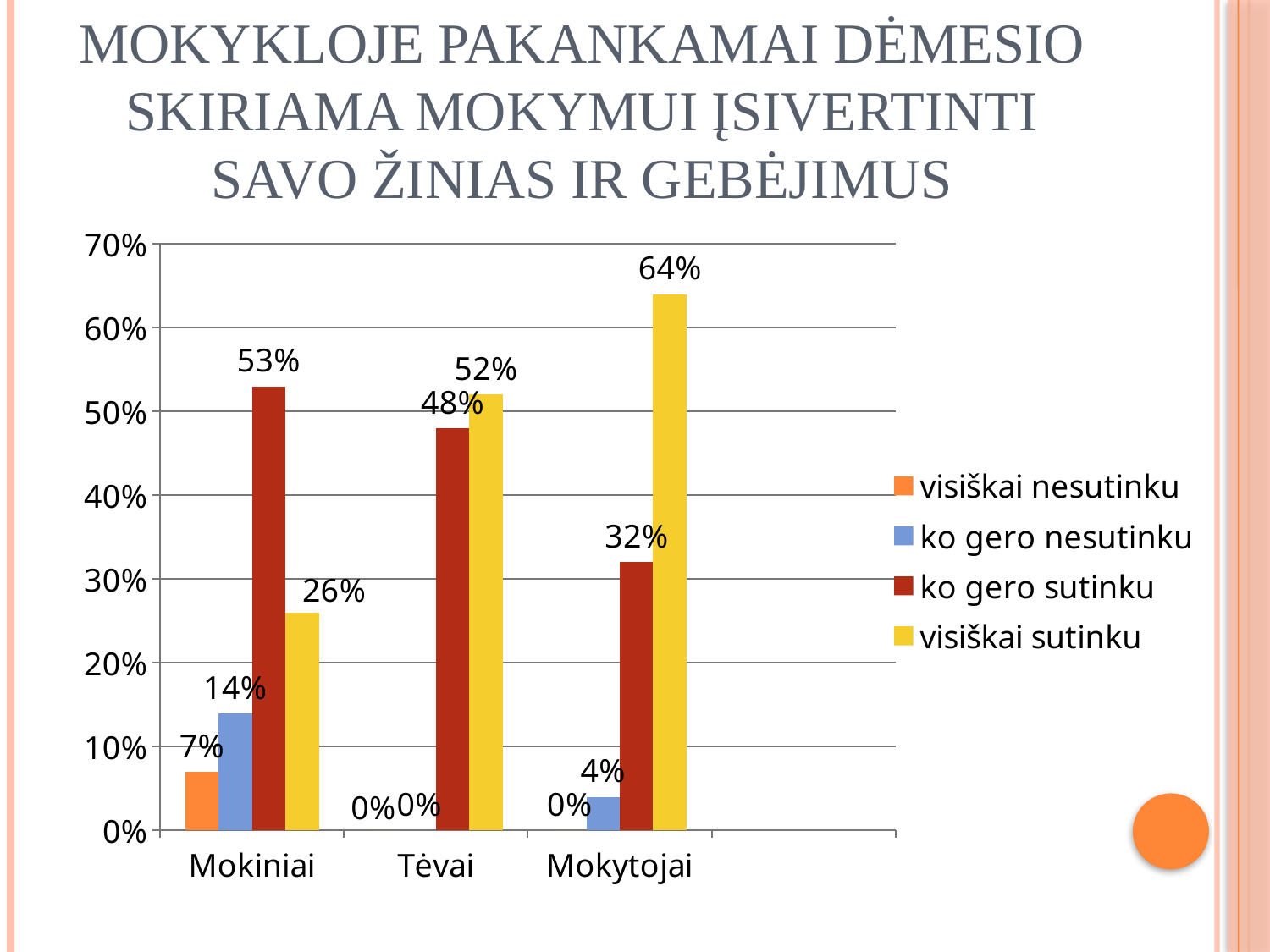
What is the value for "visiškai sutinku" in the Tėvai category? 52% Which category has the highest value for "visiškai sutinku"? Mokytojai What is the value for "ko gero sutinku" in the Mokiniai category? 53% How many series does the legend list? 4 What kind of chart is shown on the slide? bar chart Which colour represents the "visiškai sutinku" series? yellow What is the difference between the "visiškai sutinku" values for Mokytojai and Mokiniai? 38% What is the value for "ko gero nesutinku" in the Mokiniai category? 14% Which category has the lowest value for "ko gero sutinku"? Mokytojai What is the value for "visiškai sutinku" in the Mokytojai category? 64% How many categories are shown on the x axis? 3 Which is larger in the Tėvai category: "ko gero sutinku" or "visiškai sutinku"? visiškai sutinku